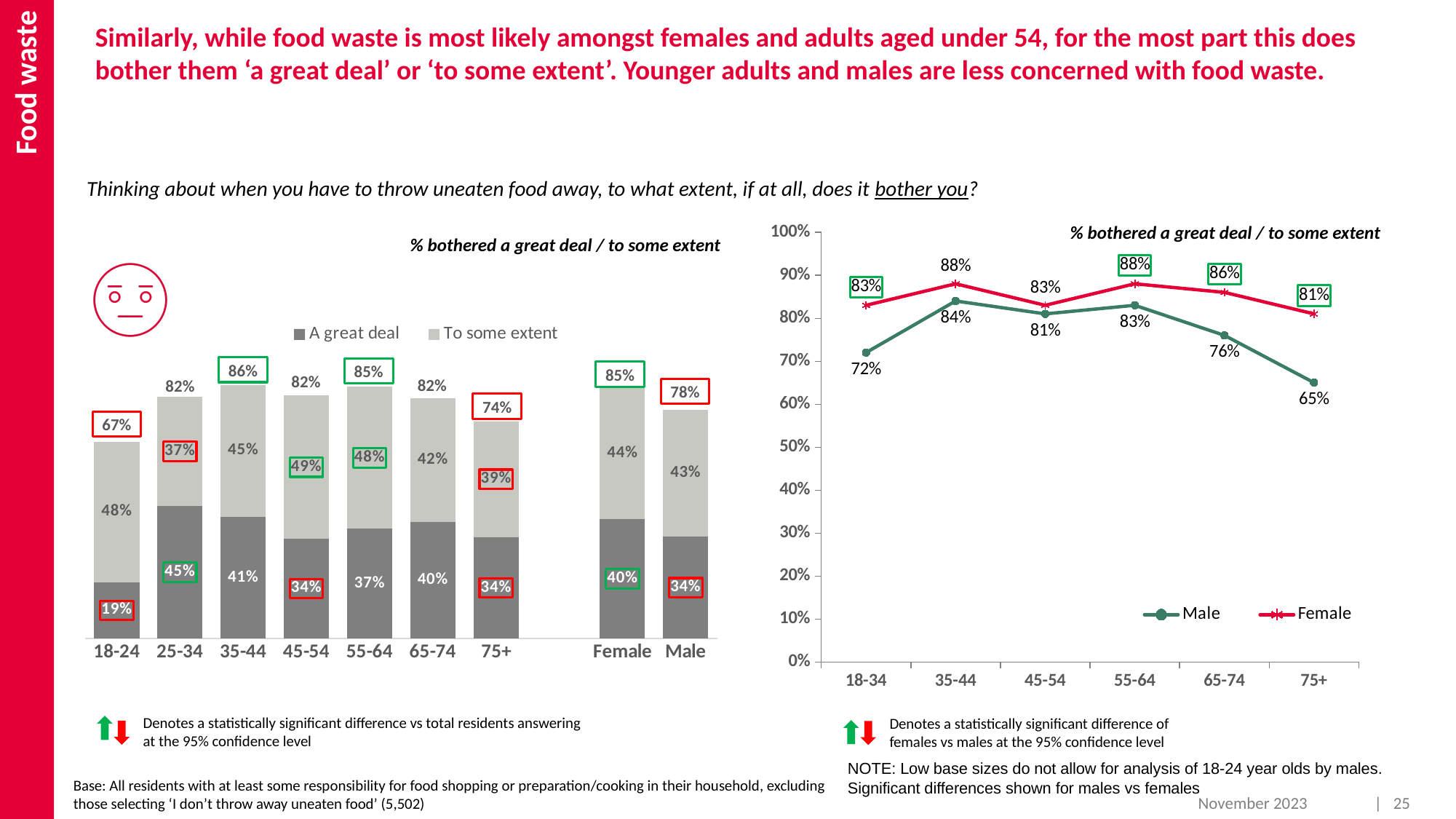
In the stacked bar chart on the left, what is the total '% bothered a great deal / to some extent' for the 35-44 age group? 86% In the line chart on the right, what is the difference between the Female and Male values for the 75+ age group? 16 percentage points In the line chart on the right, is the Female value higher or lower than the Male value for the 45-54 age group? Higher In the stacked bar chart on the left, which age group has the lowest total '% bothered a great deal / to some extent'? 18-24 In the stacked bar chart on the left, what percentage of 18-24 year olds are bothered 'a great deal'? 19% In the stacked bar chart on the left, what percentage of Males are bothered 'to some extent'? 43% In the stacked bar chart on the left, how many series does the legend list? 2 In the line chart on the right, what is the Male value for the 18-34 age group? 72% What type of chart is shown on the left side of the slide? Stacked bar chart In the line chart on the right, how many age groups are plotted on the x axis? 6 In the line chart on the right, which age group has the lowest Male value? 75+ In the stacked bar chart on the left, what is the difference between the total for Female and the total for Male? 7 percentage points